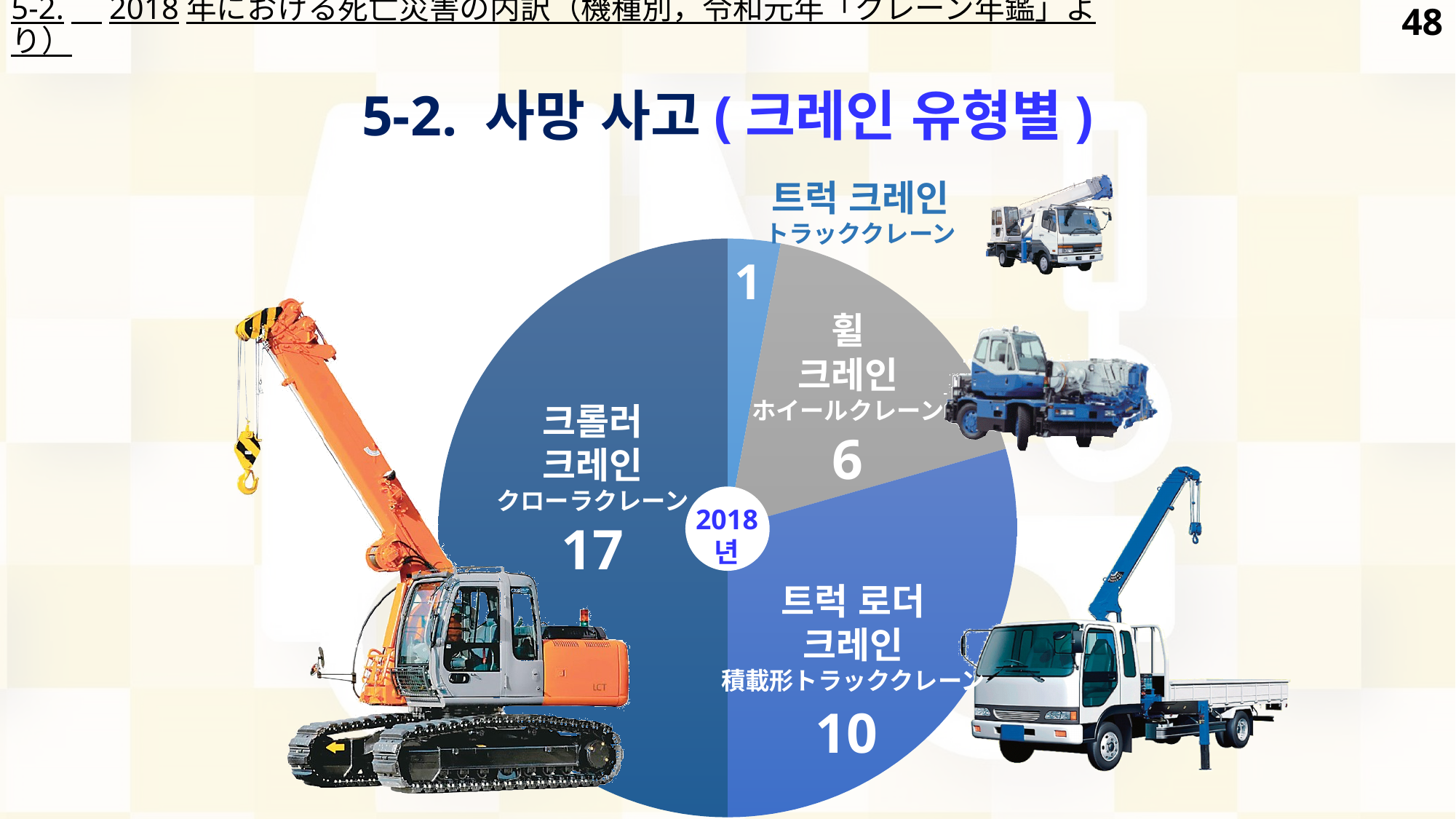
What kind of chart is shown on the slide? pie chart How many crane types (slices) are shown in the pie chart? 4 What share of the total fatal accidents does the 크롤러 크레인 slice represent? 50% What value is shown for 트럭 로더 크레인 (truck loader crane) in the pie chart? 10 Which crane type has the smallest slice in the pie chart? 트럭 크레인 (truck crane) Which is larger, the value for 휠 크레인 or the value for 트럭 로더 크레인? 트럭 로더 크레인 What year is shown in the centre of the pie chart? 2018 년 Which crane type has the largest slice in the pie chart? 크롤러 크레인 (crawler crane) What value is shown for 트럭 크레인 (truck crane) in the pie chart? 1 What value is shown for 휠 크레인 (wheel crane) in the pie chart? 6 How many fatal accidents are attributed to 크롤러 크레인 (crawler crane) in the pie chart? 17 What is the difference between the values for 크롤러 크레인 and 트럭 로더 크레인? 7